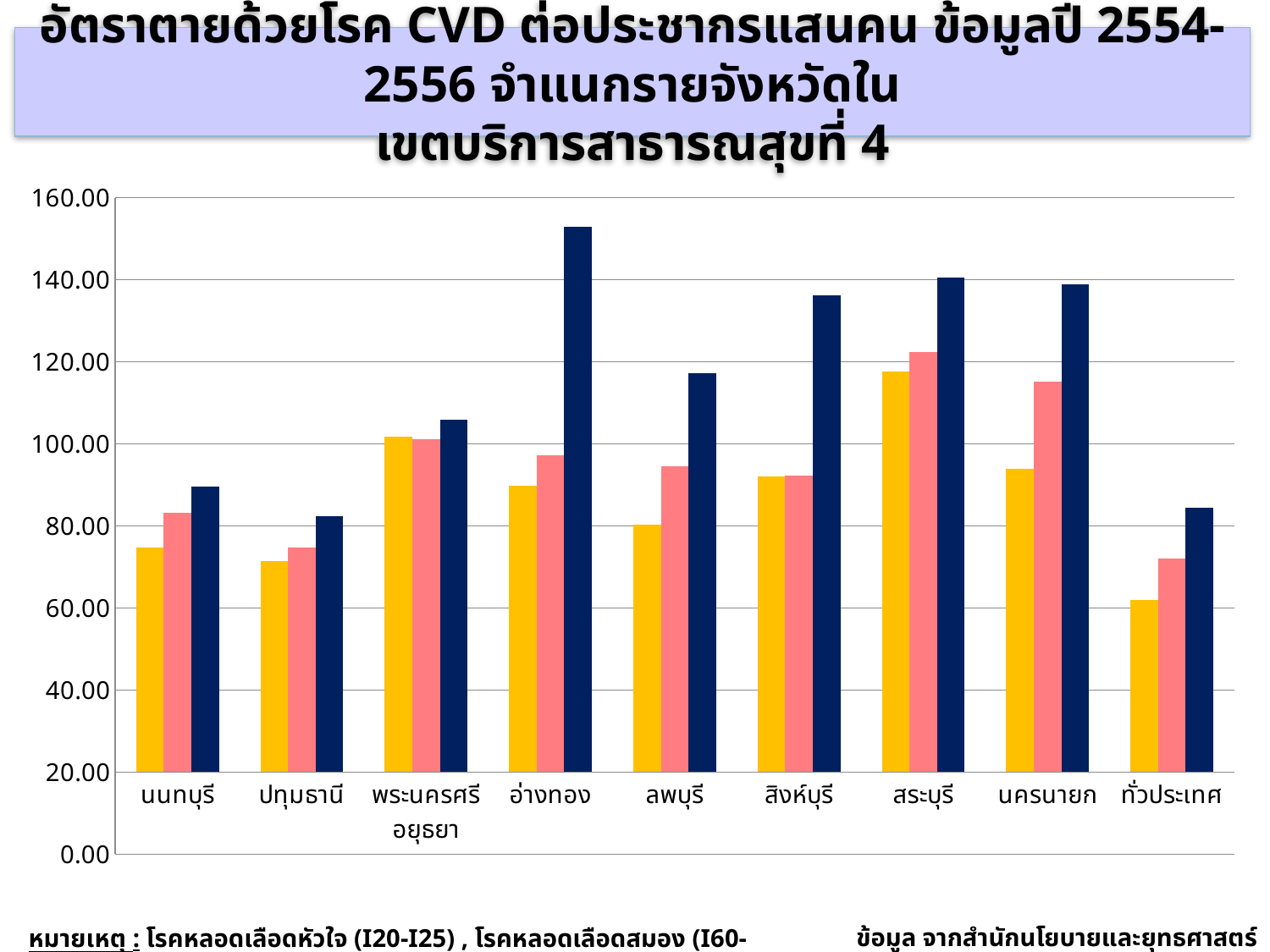
Is the dark blue bar for อ่างทอง greater or less than 140? greater What kind of chart is shown on the slide? bar chart What is the highest value shown on the vertical axis of the chart? 160.00 Which category has the tallest dark blue bar? อ่างทอง How many categories are shown along the x axis of the chart? 9 How many bars are plotted for each category in the chart? 3 Is the dark blue bar for ลพบุรี greater or less than 120? less Which category has the lowest yellow bar? ทั่วประเทศ Which has the taller dark blue bar, อ่างทอง or สระบุรี? อ่างทอง Is the yellow bar for นนทบุรี greater or less than 80? less Which category has the highest yellow bar? สระบุรี